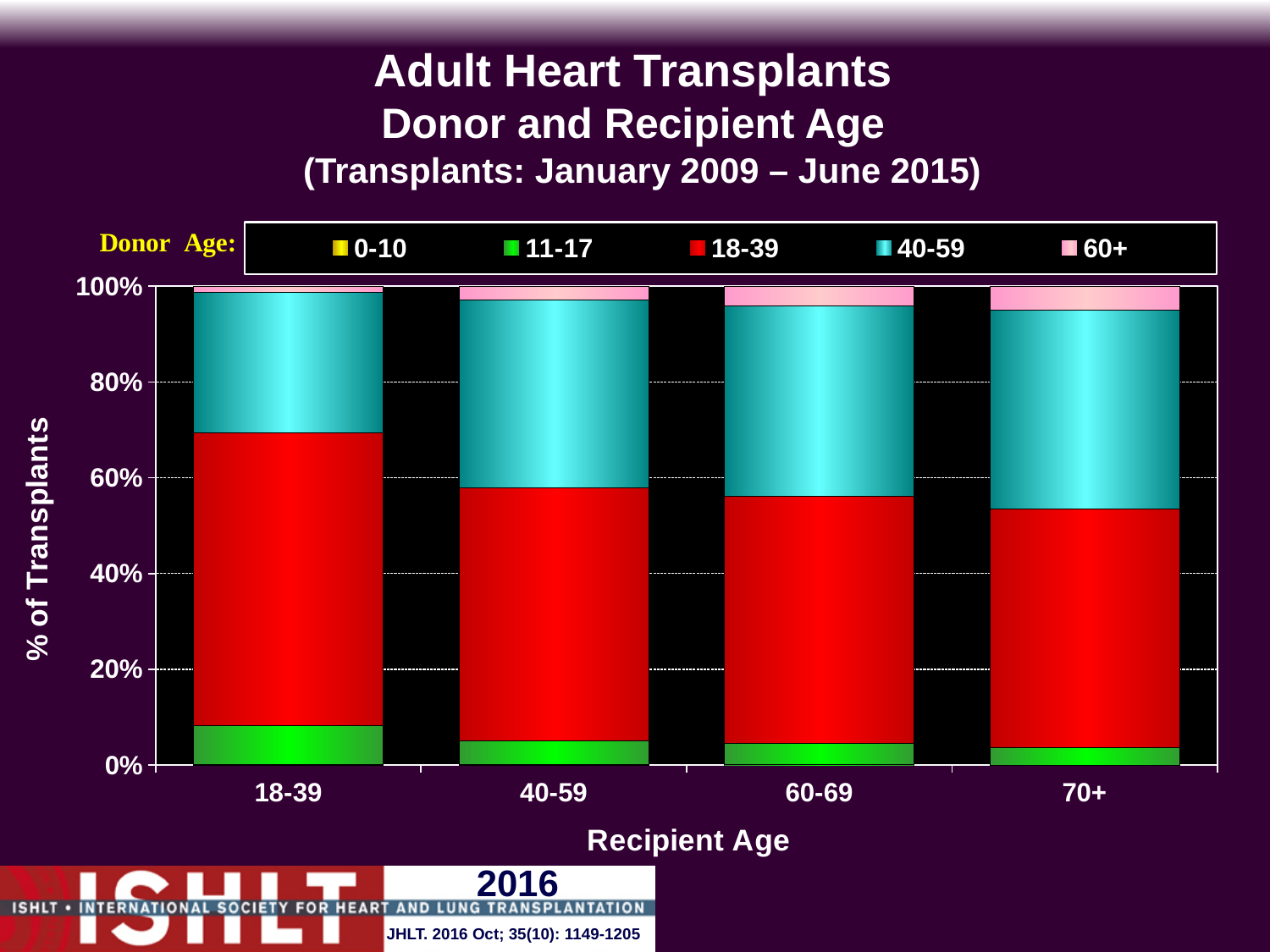
In the 60-69 recipient age bar, is the boundary between the 18-39 and 40-59 donor segments greater or less than 40%? greater In the 70+ recipient age bar, is the boundary between the 18-39 and 40-59 donor segments greater or less than 60%? less Which recipient age group has the largest share of transplants from 18-39 donors? 18-39 As recipient age increases from 18-39 to 70+, does the share of transplants from 18-39 donors rise or fall? Fall How many donor age groups does the legend list? 5 What kind of chart is shown on the slide? Stacked bar chart What is the title of the x axis? Recipient Age Which recipient age group has the largest share of transplants from 11-17 donors? 18-39 Which recipient age group has the largest share of transplants from 60+ donors? 70+ How many recipient age groups are shown on the x axis? 4 In the 18-39 recipient age bar, is the boundary between the 18-39 and 40-59 donor segments greater or less than 60%? greater What is the total of each stacked bar? 100%